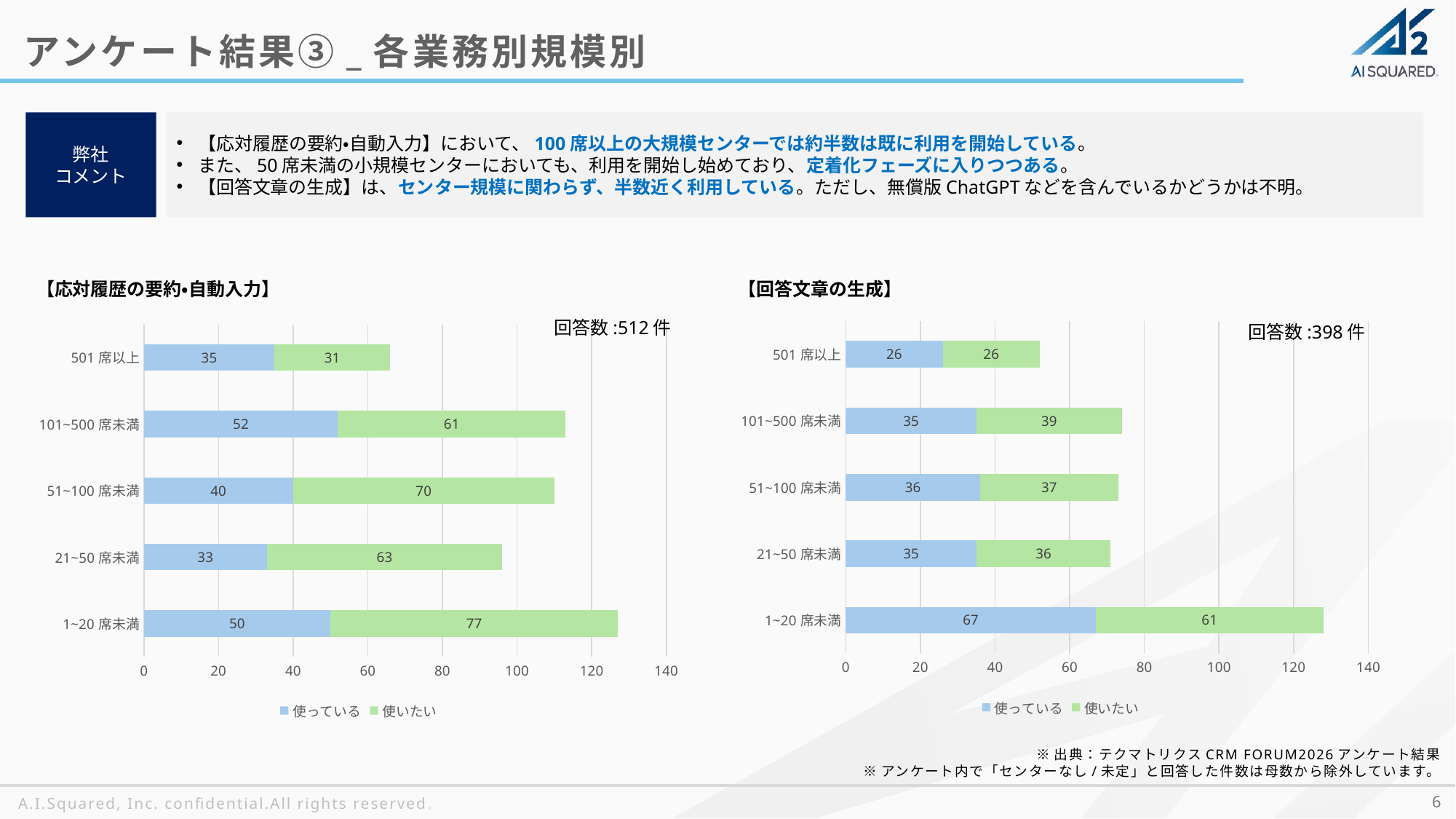
In the 【回答文章の生成】 chart, what is the total of the stacked bar for 101~500席未満? 74 In the 【応対履歴の要約•自動入力】 chart, which category has the highest 使いたい value? 1~20席未満 In the 【回答文章の生成】 chart, is the 使っている value for 1~20席未満 larger or smaller than the 使っている value for 501席以上? larger In the 【応対履歴の要約•自動入力】 chart, what is the 使いたい value for 1~20席未満? 77 In the 【応対履歴の要約•自動入力】 chart, which category has the lowest 使っている value? 21~50席未満 In the 【応対履歴の要約•自動入力】 chart, what is the 使っている value for 101~500席未満? 52 In the 【応対履歴の要約•自動入力】 chart, what is the total of the stacked bar for 51~100席未満? 110 In the 【回答文章の生成】 chart, what is the 使っている value for 1~20席未満? 67 In the 【回答文章の生成】 chart, which category has the highest 使っている value? 1~20席未満 In the 【回答文章の生成】 chart, what is the 使いたい value for 501席以上? 26 How many series does the legend of the 【回答文章の生成】 chart list? 2 In the 【応対履歴の要約•自動入力】 chart, what is the difference between the 使いたい and 使っている values for 21~50席未満? 30